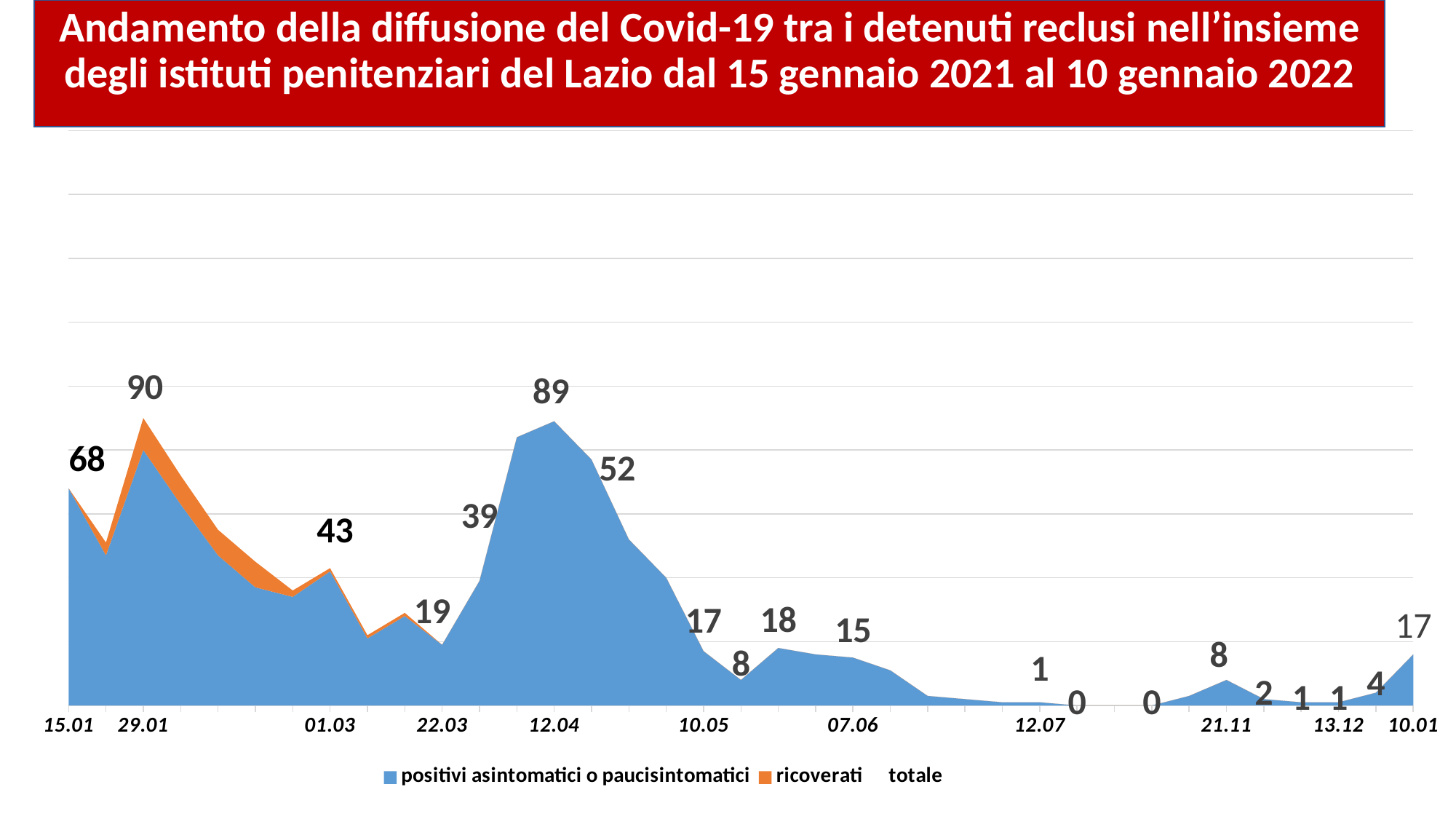
What is the total value shown for 29.01? 90 On which date does the total reach its highest value? 29.01 What is the total value shown for 07.06? 15 Which is larger, the total on 29.01 or the total on 12.04? 29.01 What is the lowest total value labelled on the chart? 0 What is the total value shown for 10.01? 17 What is the total value shown for 15.01? 68 What is the difference between the total on 29.01 and the total on 15.01? 22 Does the total rise or fall between 12.04 and 12.07? fall How many series does the legend list? 3 What kind of chart is shown on the slide? area chart What is the total value shown for 12.04? 89